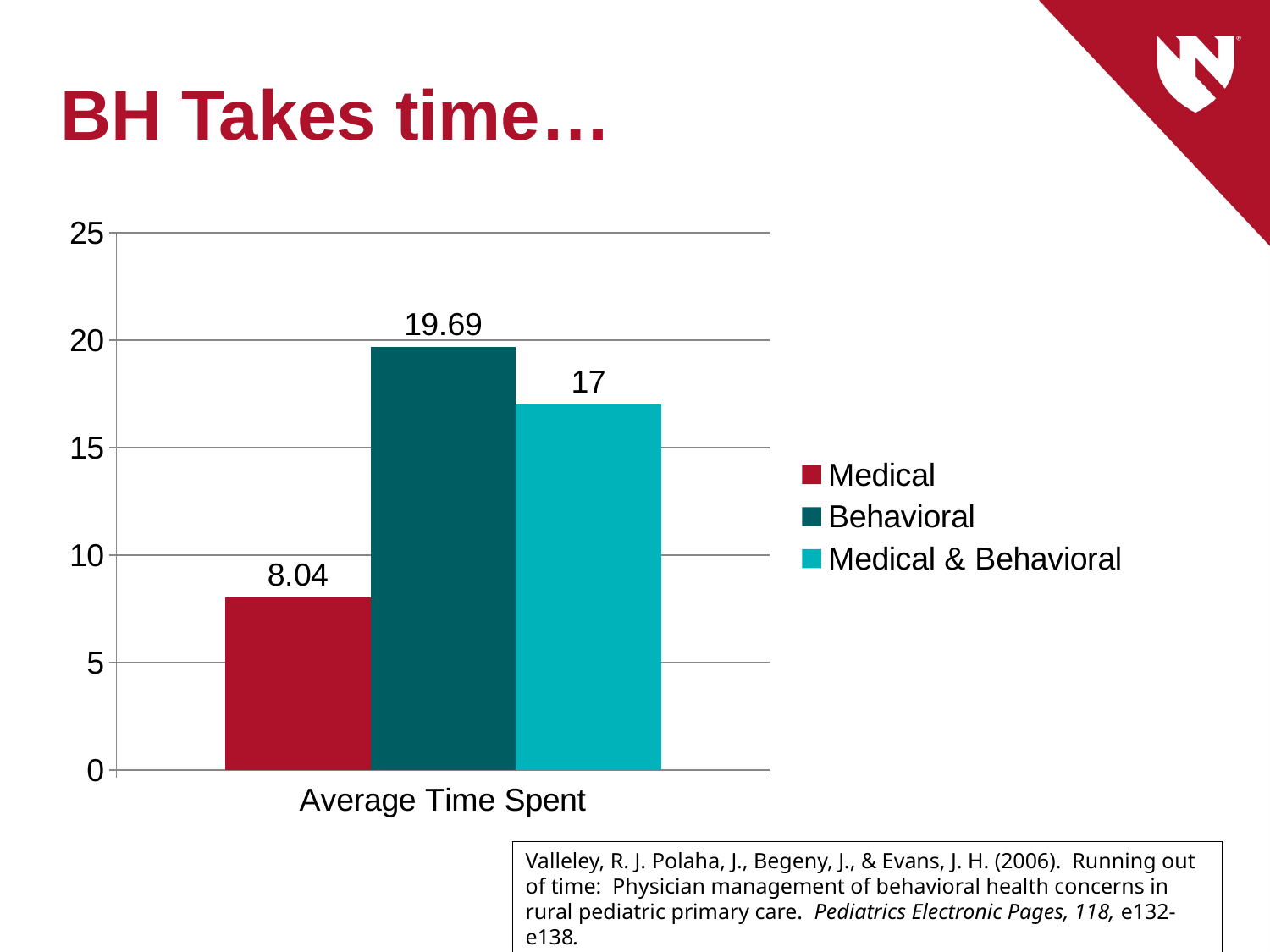
What is the difference between the Behavioral and Medical & Behavioral values? 2.69 What is the value for Behavioral in the Average Time Spent chart? 19.69 What is the value for Medical & Behavioral in the Average Time Spent chart? 17 Which series has the highest value in the chart? Behavioral Which series has the lowest value in the chart? Medical What is the category label shown on the x axis of the chart? Average Time Spent Which is larger, the value for Medical or the value for Medical & Behavioral? Medical & Behavioral What kind of chart is shown on the slide? bar chart How many series does the legend list? 3 Is the value for Behavioral greater or less than 15? greater What is the difference between the Behavioral and Medical values? 11.65 What is the value for Medical in the Average Time Spent chart? 8.04